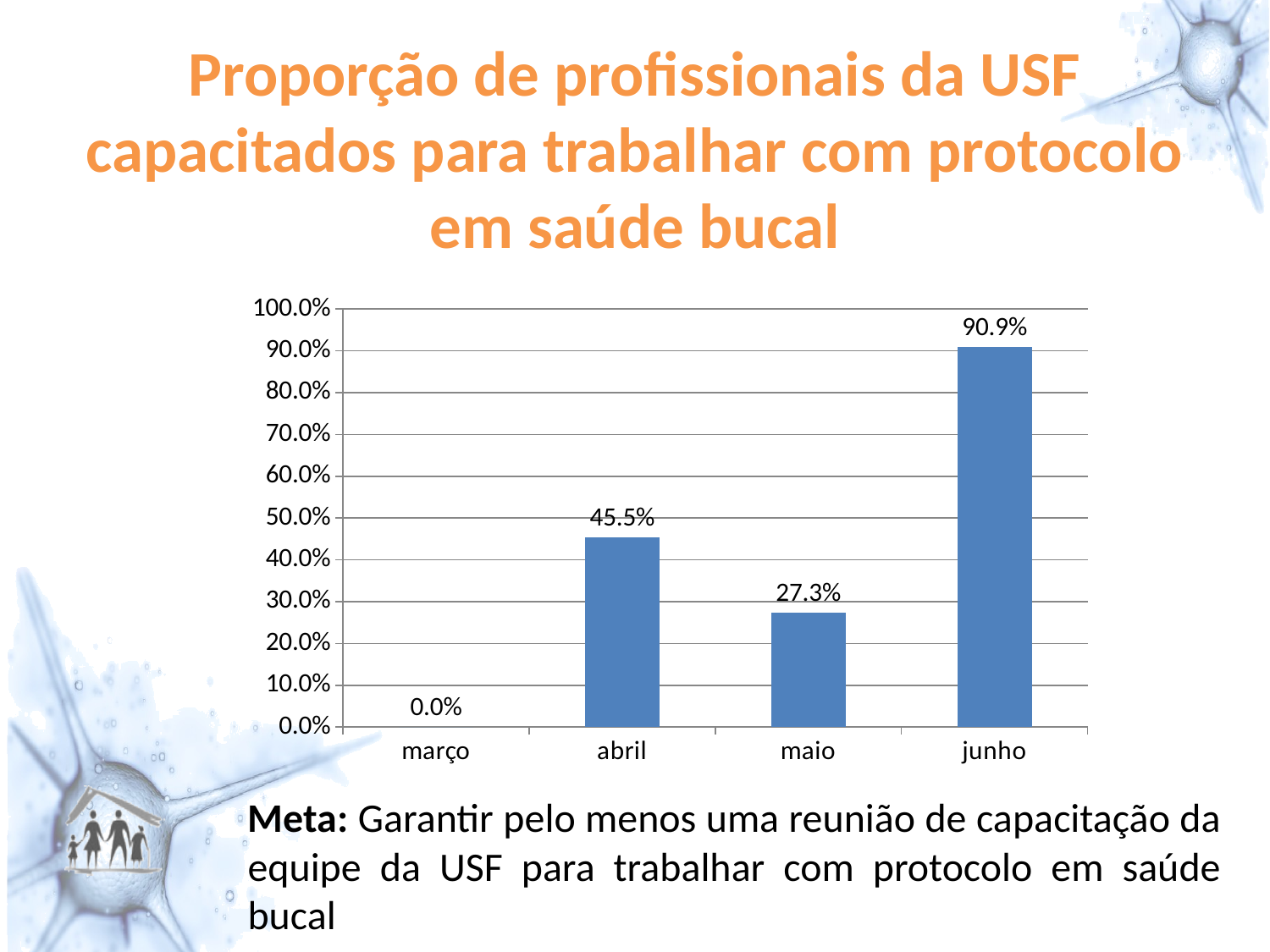
Which month has the lowest value? março Which month has the highest value? junho Is the value for junho greater or less than 80.0%? greater What is the value for abril? 45.5% Does the value rise or fall from maio to junho? rise What is the value for março? 0.0% What kind of chart is shown on the slide? bar chart What is the value for maio? 27.3% Which is larger, the value for abril or the value for maio? abril What is the value for junho? 90.9% How many months are shown on the x axis? 4 What is the difference between the values for junho and abril? 45.4%